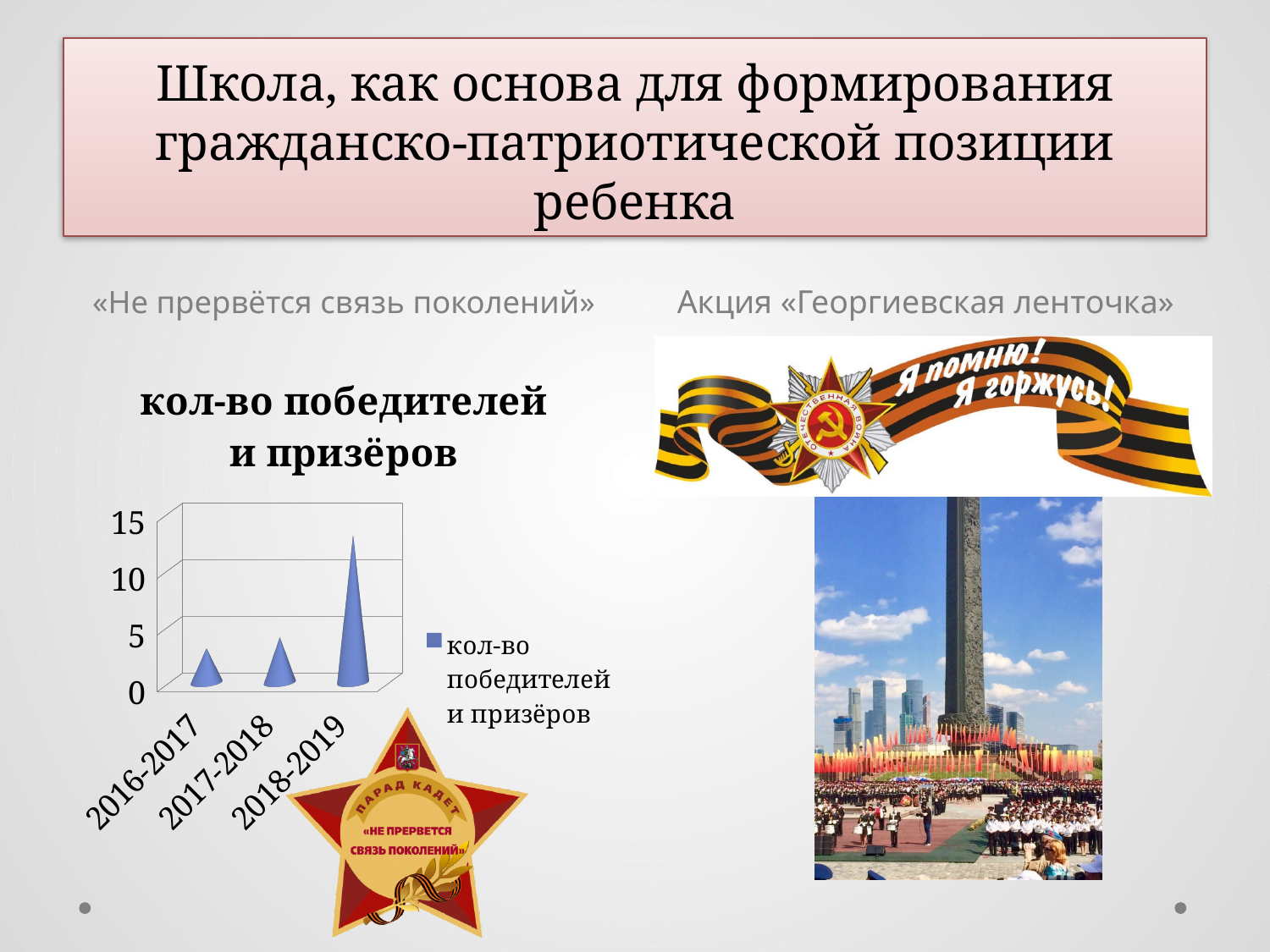
What is the highest tick value shown on the chart's vertical axis? 15 What is the title of the chart on the left side of the slide? кол-во победителей и призёров Which is larger, the value for 2018-2019 or the value for 2017-2018? 2018-2019 What is the legend entry of the chart? кол-во победителей и призёров Is the value for 2018-2019 greater or less than 10? greater What kind of chart is shown under the heading «Не прервётся связь поколений»? bar chart Is the value for 2017-2018 greater or less than 5? less Is the value for 2016-2017 greater or less than 5? less How many series does the chart's legend list? 1 Do the values in the chart rise or fall from 2016-2017 to 2018-2019? rise How many categories (school years) are shown on the x axis of the chart? 3 Which school year has the highest value in the chart? 2018-2019